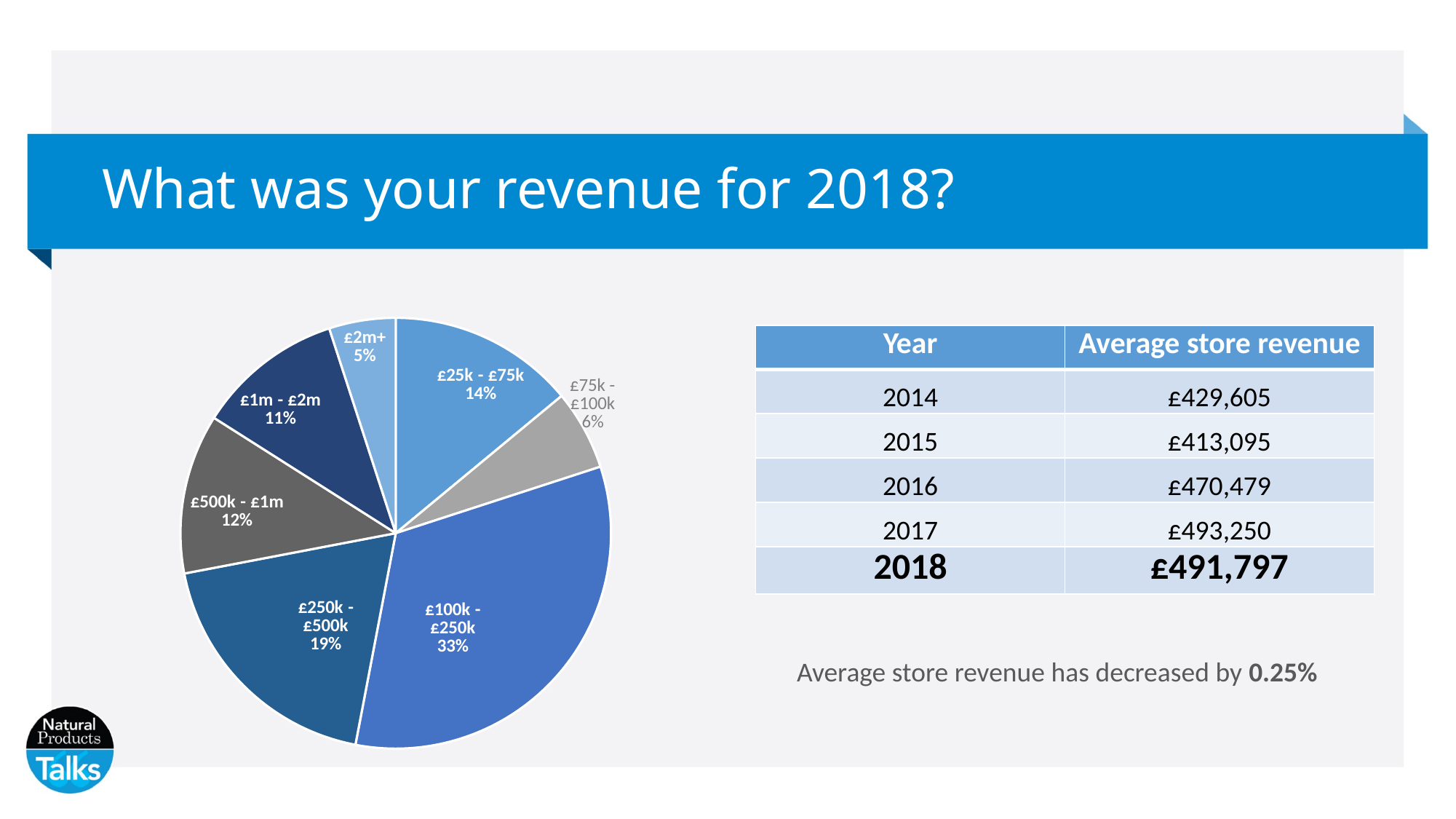
Which revenue band has the smallest share of the pie? £2m+ Which is larger, the £25k - £75k slice or the £500k - £1m slice? £25k - £75k What is the combined share of the £1m - £2m and £2m+ slices? 16% What is the value for the £2m+ slice? 5% What is the value for the £75k - £100k slice? 6% What share of the pie does the £100k - £250k slice represent? 33% Which revenue band has the largest share of the pie? £100k - £250k What is the difference between the £1m - £2m share and the £2m+ share? 6% What is the value for the £250k - £500k slice? 19% How many slices does the pie chart have? 7 What is the difference between the £100k - £250k share and the £250k - £500k share? 14% What type of chart is shown on the slide? pie chart